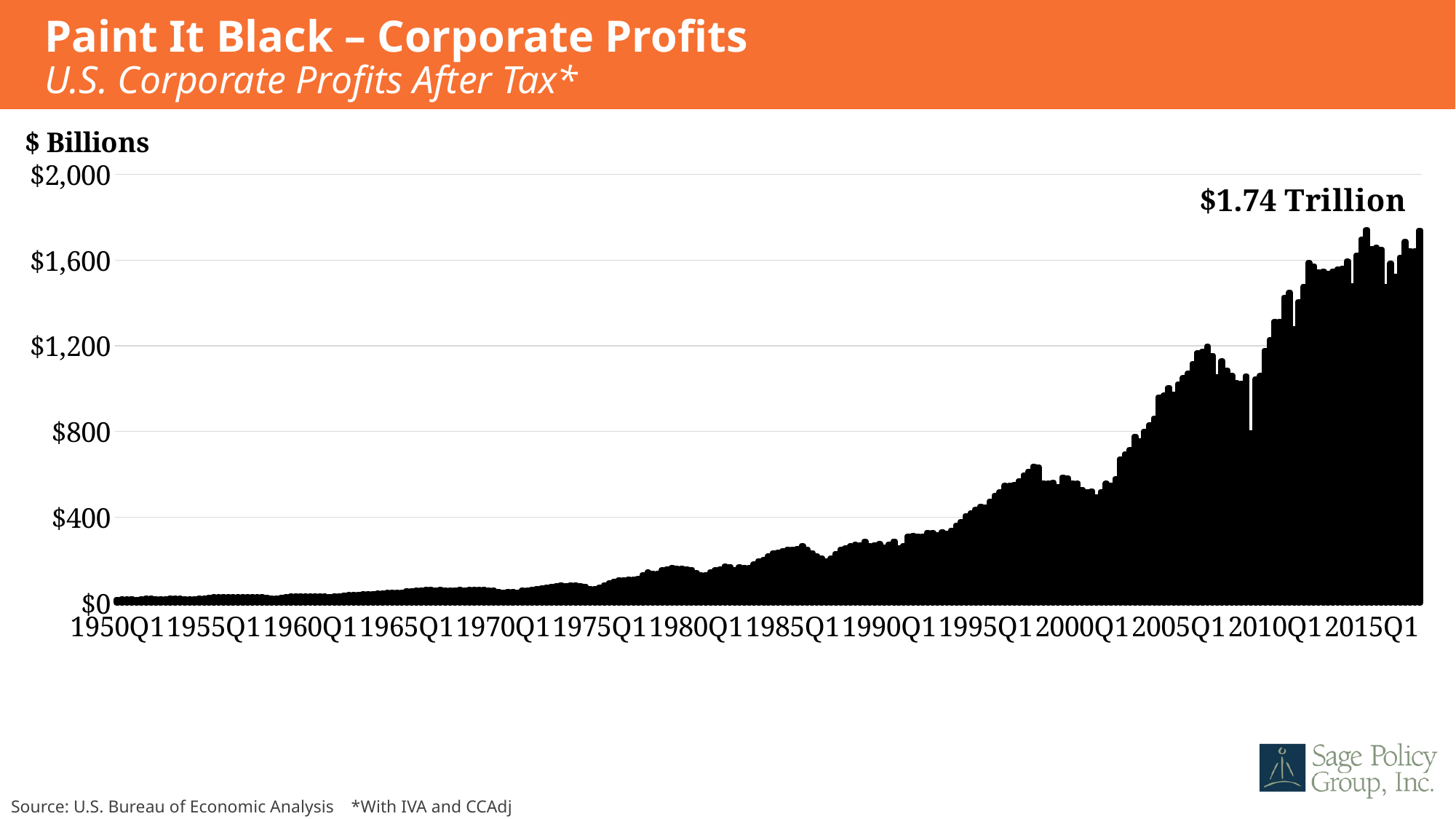
Which is larger, the value for 2015Q1 or the value for 1995Q1? 2015Q1 Is the value for 2005Q1 greater or less than $800? greater What is the first label on the horizontal axis? 1950Q1 Is the peak value on the chart greater or less than $2,000? less What value is labelled at the right end of the chart for the most recent corporate profits? $1.74 Trillion What unit is shown above the vertical axis? $ Billions Is the highest value on the chart found near the beginning or near the end of the period? near the end Is the value for 2000Q1 greater or less than $400? greater What kind of chart is shown on the slide? bar chart Do U.S. corporate profits after tax generally rise or fall from 1950Q1 to the end of the period? rise